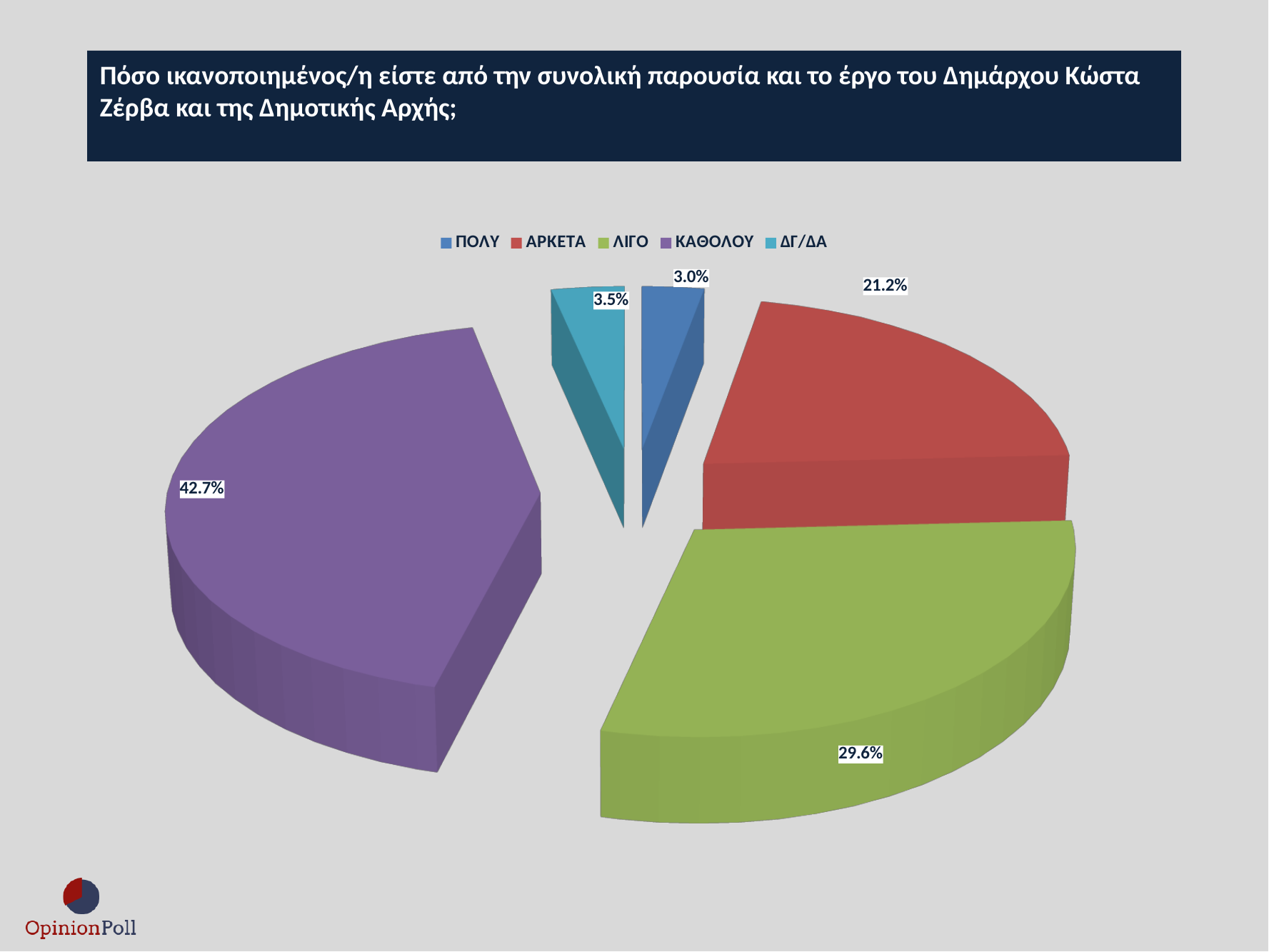
Which category has the smallest share of the pie? ΠΟΛΥ What percentage is shown for ΠΟΛΥ? 3.0% What colour is the ΚΑΘΟΛΟΥ slice? purple What percentage is shown for ΑΡΚΕΤΑ? 21.2% Which category has the largest share of the pie? ΚΑΘΟΛΟΥ What is the difference in percentage points between ΚΑΘΟΛΟΥ and ΛΙΓΟ? 13.1 How many categories does the legend list? 5 What percentage is shown for ΚΑΘΟΛΟΥ? 42.7% Which is larger, the share for ΑΡΚΕΤΑ or the share for ΛΙΓΟ? ΛΙΓΟ What percentage is shown for ΔΓ/ΔΑ? 3.5% What kind of chart is shown on the slide? pie chart What percentage is shown for ΛΙΓΟ? 29.6%